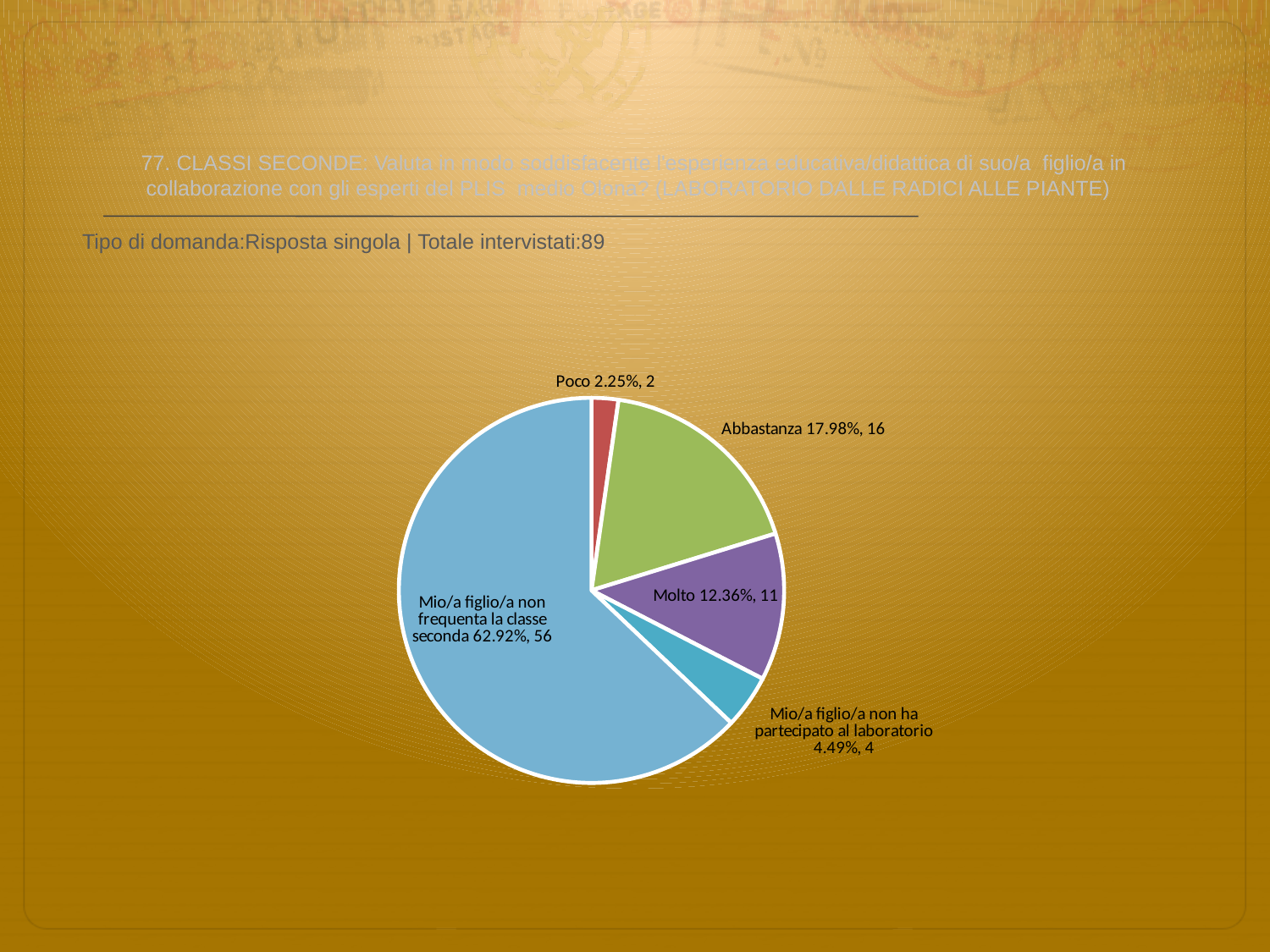
What percentage share does the 'Molto' slice have? 12.36% What is the total number of respondents stated on the slide? 89 How many respondents answered 'Poco'? 2 Which category has the smallest slice of the pie? Poco How many respondents answered 'Abbastanza'? 16 Which is larger, the 'Molto' slice or the 'Mio/a figlio/a non ha partecipato al laboratorio' slice? Molto What percentage share does the 'Mio/a figlio/a non ha partecipato al laboratorio' slice have? 4.49% What is the difference in count between 'Abbastanza' and 'Molto'? 5 Which category has the largest slice of the pie? Mio/a figlio/a non frequenta la classe seconda What colour is the 'Abbastanza' slice? green What kind of chart is shown on the slide? pie chart How many slices does the pie chart have? 5